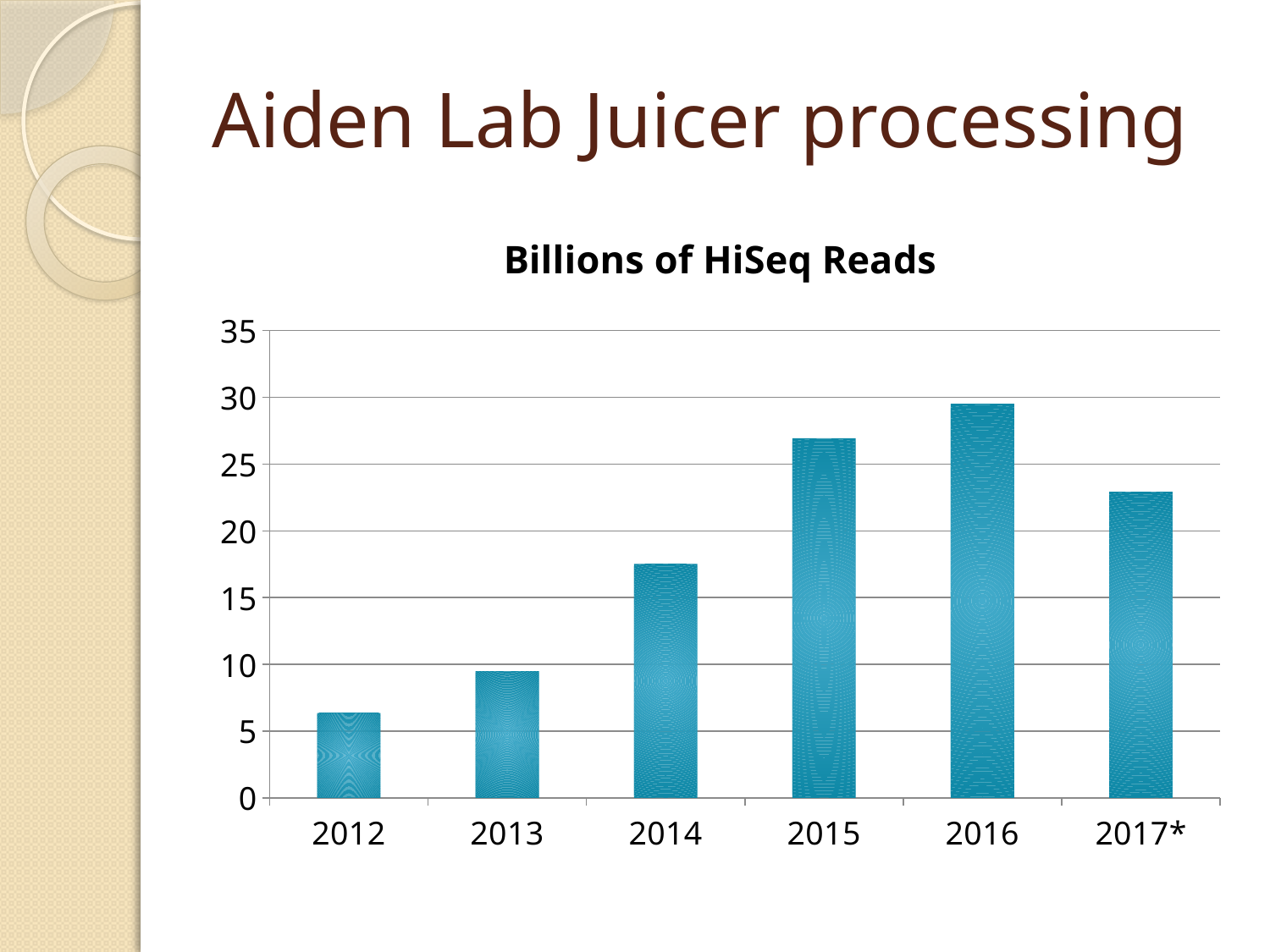
Is the value for 2015 greater or less than 25? greater What is the last category label on the x axis? 2017* Is the value for 2017* greater or less than 25? less Which year has the lowest value? 2012 Is the value for 2014 greater or less than 15? greater Which year has the highest value? 2016 Which is larger, the value for 2015 or the value for 2017*? 2015 Do the values rise or fall from 2012 to 2016? rise What is the title of the chart? Billions of HiSeq Reads What kind of chart is shown on the slide? bar chart How many years (categories) are shown on the x axis? 6